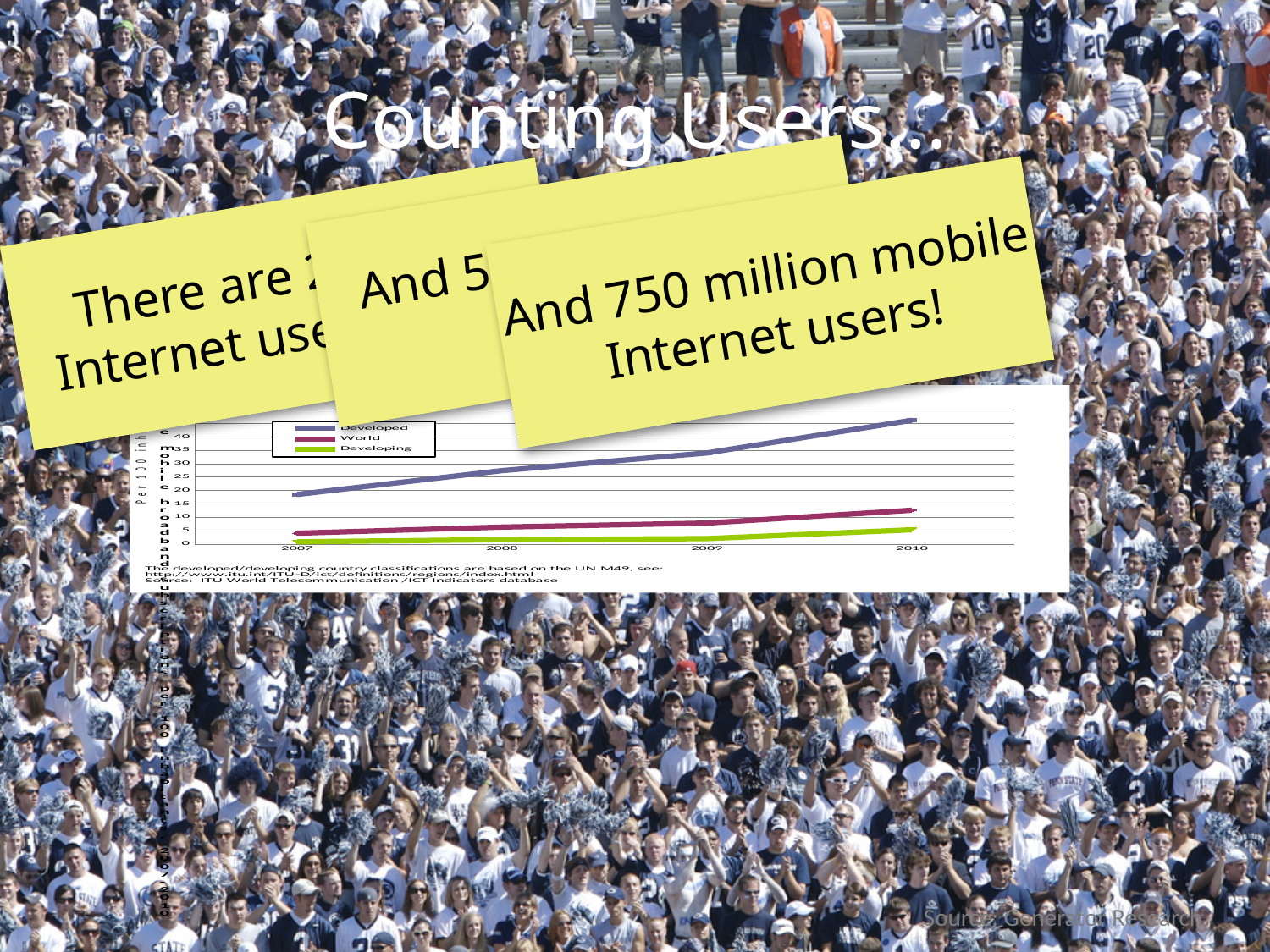
Does the Developed series rise or fall from 2007 to 2010? rise Is the value for Developing in 2010 greater or less than 10? less What colour is the Developing line in the chart? green Is the value for Developed in 2010 greater or less than 40? greater In 2009, which is larger: the value for World or the value for Developing? World How many years are shown along the x axis of the chart? 4 Which series has the lowest values across the chart? Developing Which series are listed in the chart's legend? Developed, World, Developing Which series has the highest values across the chart? Developed What kind of chart is shown on the slide? line chart How many series does the chart's legend list? 3 Is the value for World in 2010 greater or less than 15? less